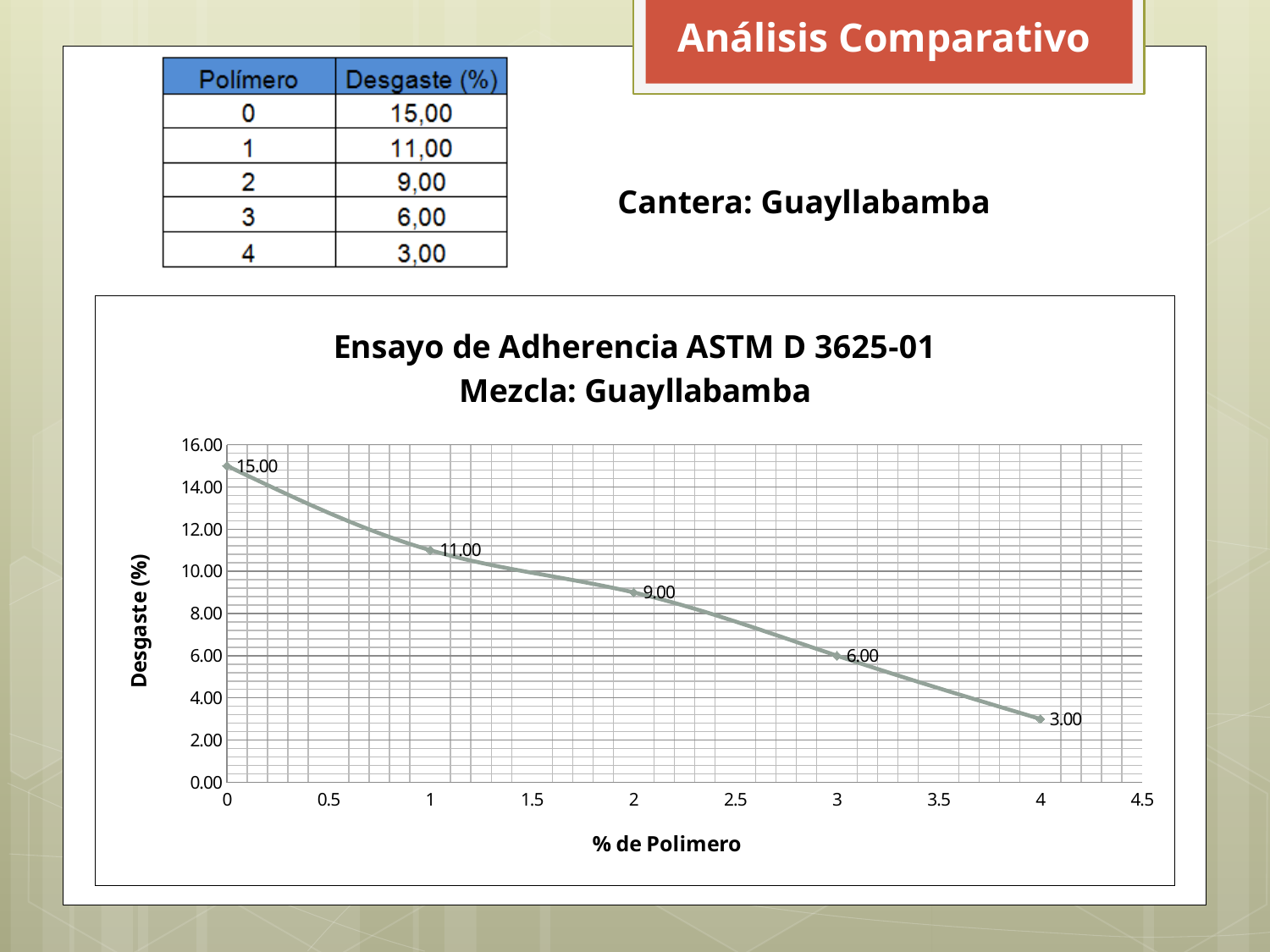
At which % de Polimero is the Desgaste (%) lowest? 4 What is the Desgaste (%) value at 2% de Polimero? 9.00 What is the Desgaste (%) value at 4% de Polimero? 3.00 At which % de Polimero is the Desgaste (%) highest? 0 What is the difference in Desgaste (%) between 3% and 4% de Polimero? 3.00 Is the Desgaste (%) value at 2% de Polimero greater or less than 10.00? less How many data points are plotted on the chart? 5 What is the Desgaste (%) value at 0% de Polimero? 15.00 Does the Desgaste (%) rise or fall as % de Polimero increases? fall What is the difference in Desgaste (%) between 0% and 1% de Polimero? 4.00 Which has a higher Desgaste (%): 1% de Polimero or 3% de Polimero? 1% de Polimero What kind of chart is shown on the slide? line chart